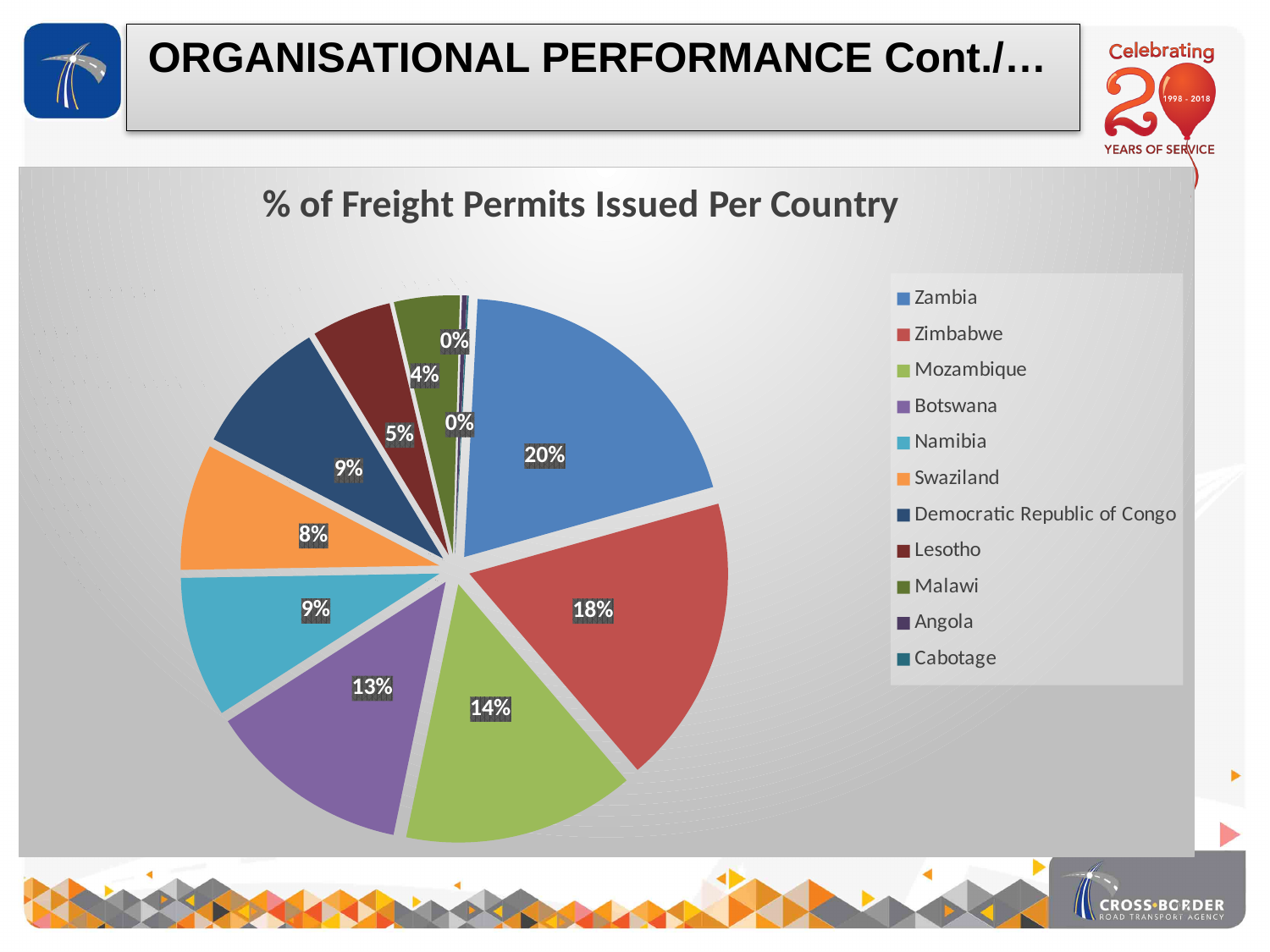
Which has a larger share of freight permits, Mozambique or Botswana? Mozambique What type of chart is shown on the slide? Pie chart What percentage of freight permits was issued for Zimbabwe? 18% What is the difference in percentage points between Zambia's share and Zimbabwe's share? 2% What percentage of freight permits was issued for Botswana? 13% What percentage of freight permits was issued for Lesotho? 5% What percentage of freight permits was issued for Swaziland? 8% What is the title of the pie chart? % of Freight Permits Issued Per Country Which country has the largest share of freight permits issued? Zambia What percentage of freight permits was issued for Zambia? 20% How many entries does the legend list? 11 What percentage of freight permits was issued for Mozambique? 14%